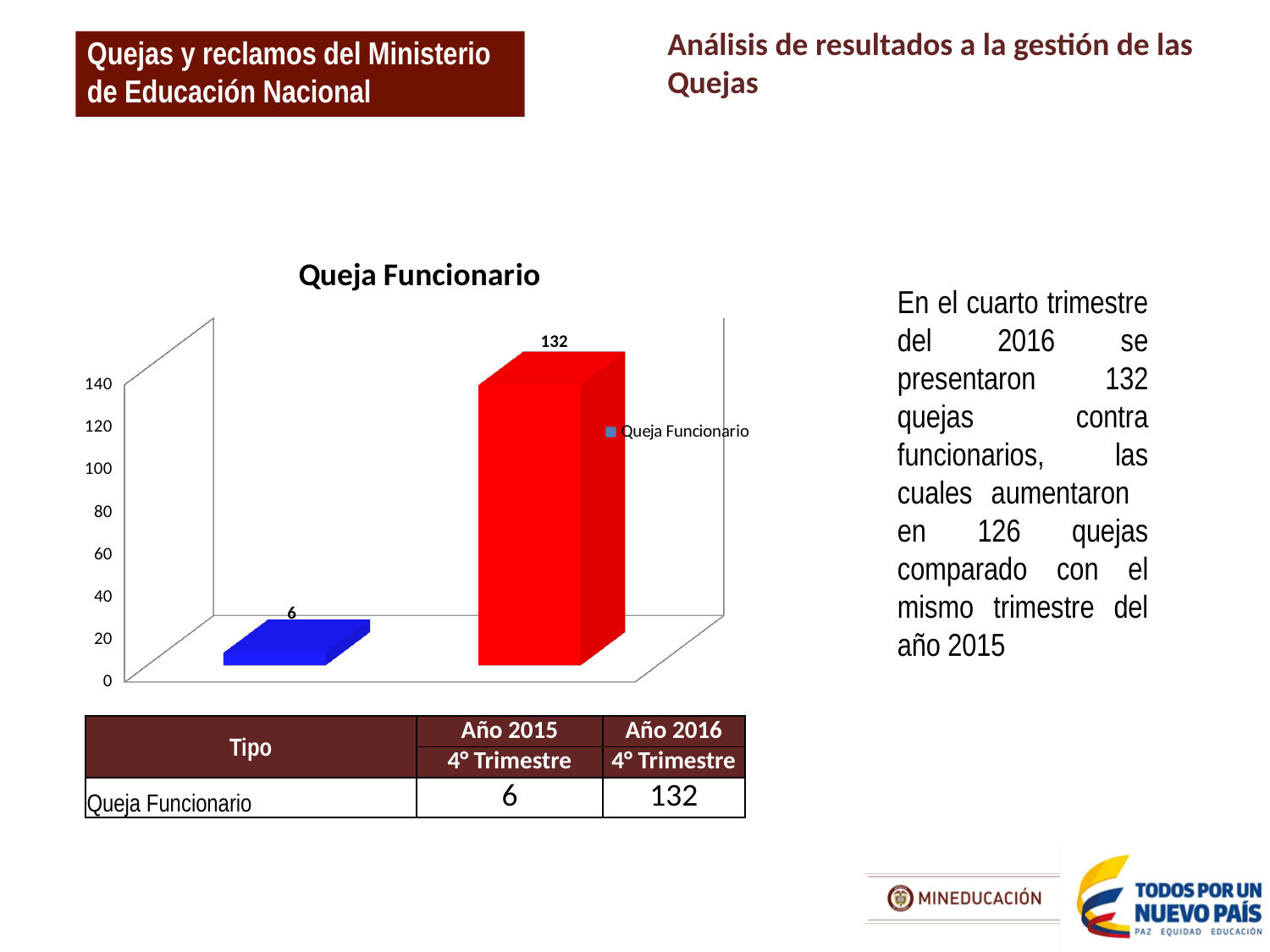
What kind of chart is shown on the slide? bar chart Do the bar values rise or fall from left to right in the chart? rise What is the legend entry of the chart? Queja Funcionario Which bar is taller in the chart, the blue bar or the red bar? the red bar How many bars are plotted in the chart? 2 Is the value of the red bar greater or less than 100? greater What is the value shown on the red bar in the chart? 132 What is the difference between the values of the red bar and the blue bar? 126 What is the value shown on the blue bar in the chart? 6 Is the value of the blue bar greater or less than 20? less How many series does the chart legend list? 1 What is the title of the chart? Queja Funcionario